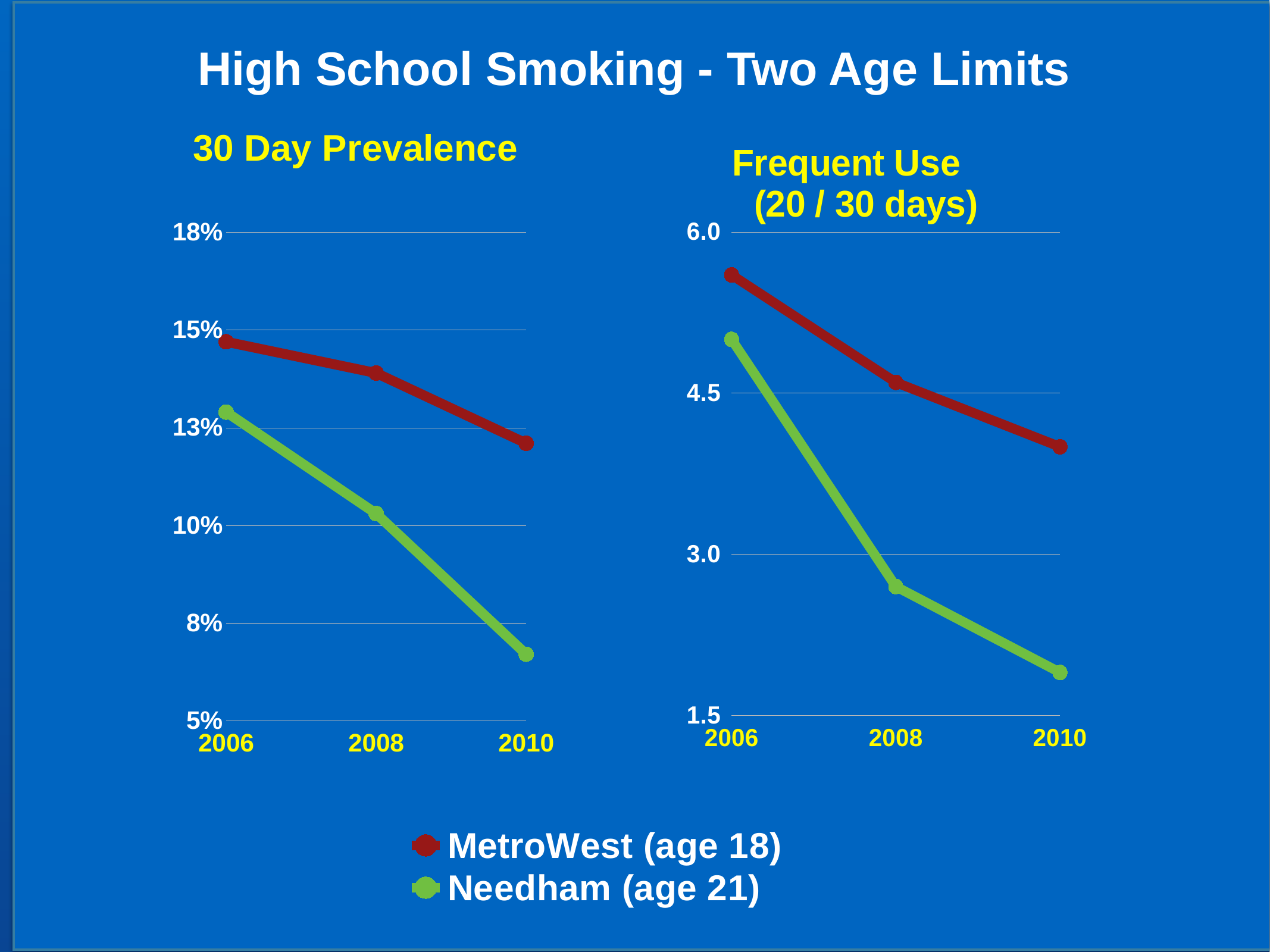
How many series does the legend list? 2 In the '30 Day Prevalence' chart, is the value for MetroWest (age 18) in 2010 greater or less than 13%? less In the 'Frequent Use (20 / 30 days)' chart, is the value for Needham (age 21) in 2010 greater or less than 1.5? greater How many years are plotted on the x axis of the 'Frequent Use (20 / 30 days)' chart? 3 In the '30 Day Prevalence' chart, does the Needham (age 21) line rise or fall from 2006 to 2010? fall Which colour is used for the Needham (age 21) series? green What kind of chart is the '30 Day Prevalence' chart? line chart In the '30 Day Prevalence' chart, which series has the higher value in 2010, MetroWest (age 18) or Needham (age 21)? MetroWest (age 18) In the 'Frequent Use (20 / 30 days)' chart, is the value for Needham (age 21) in 2006 greater or less than 4.5? greater In the 'Frequent Use (20 / 30 days)' chart, does the MetroWest (age 18) line rise or fall from 2006 to 2010? fall